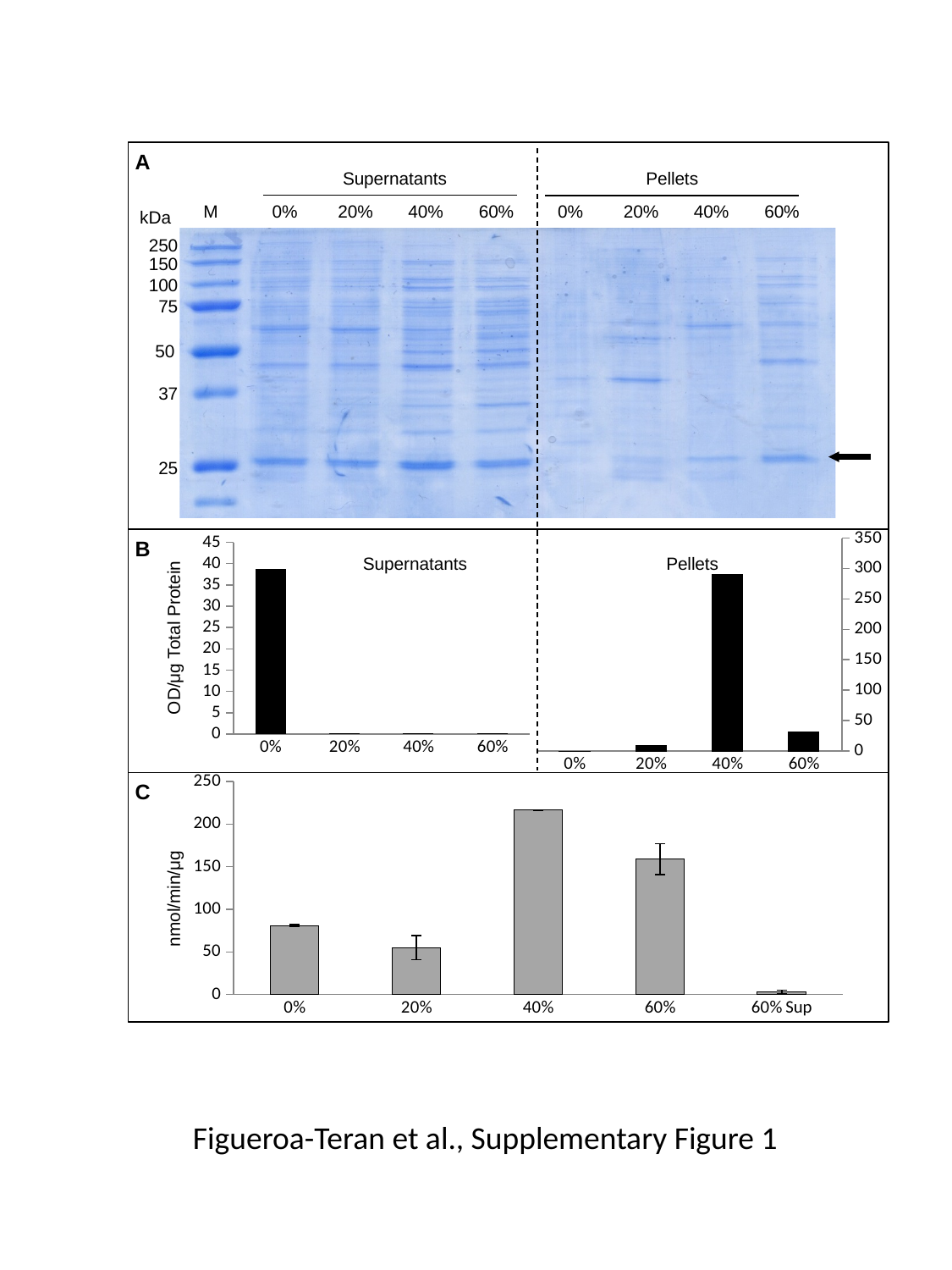
How many categories are shown on the x axis of panel C? 5 In panel C, which category has the lowest value? 60% Sup What is the y-axis label of panel C? nmol/min/µg In panel C, is the value for 20% greater or less than 100? less In panel C, which is larger, the value for 0% or the value for 20%? 0% In the Pellets chart of panel B, which category has the highest value? 40% In the Supernatants chart of panel B, which category has the highest value? 0% In panel C, is the value for 40% greater or less than 200? greater In the Pellets chart of panel B, is the value for 40% greater or less than 250? greater What kind of chart is panel C? bar chart In panel C, which category has the highest value? 40%